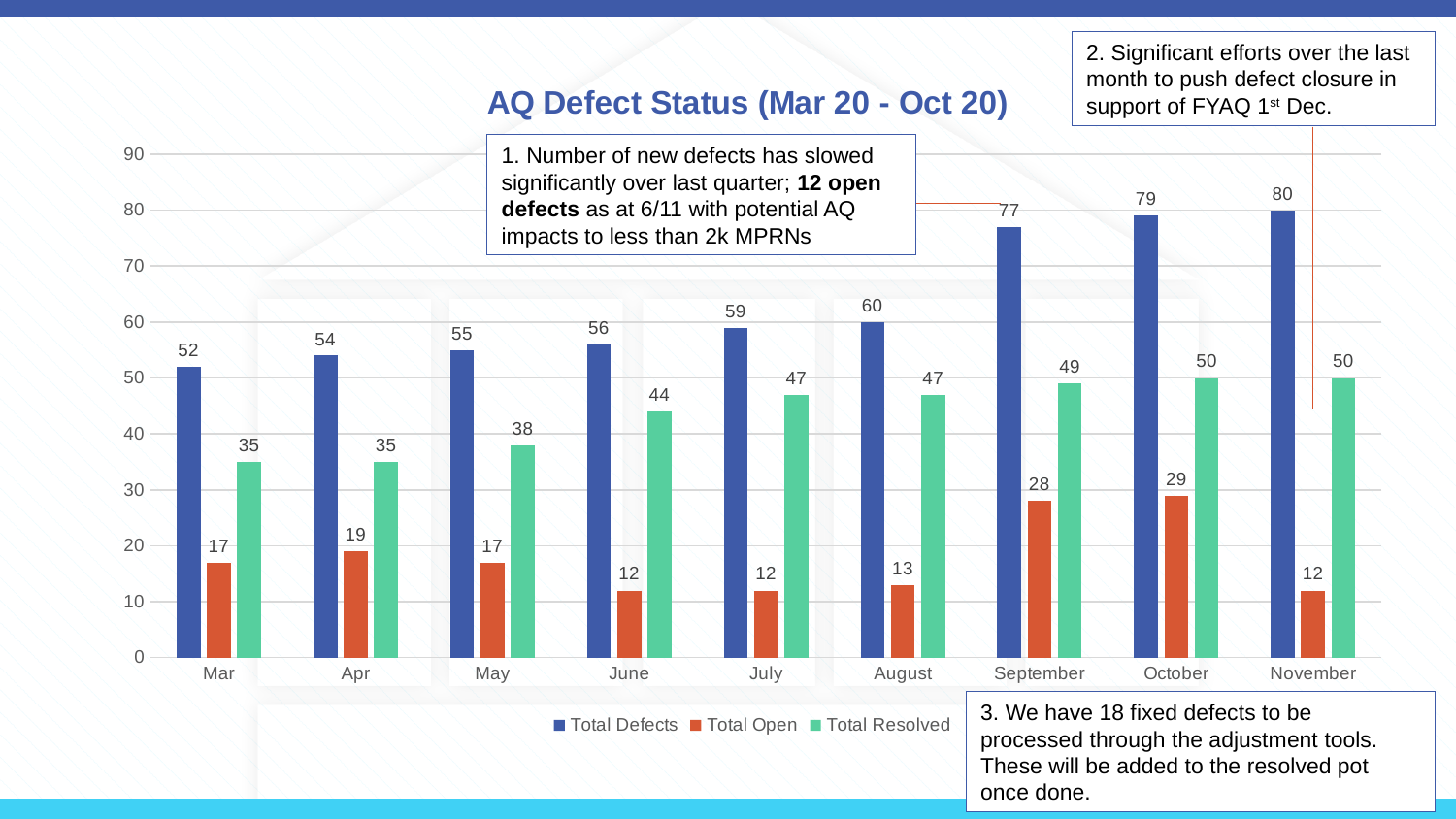
What is the Total Resolved value for June? 44 What is the Total Defects value for November? 80 How many series does the legend list? 3 Which month has the lowest Total Defects value? Mar Which month has the highest Total Defects value? November What is the difference between Total Defects and Total Resolved in October? 29 Is the Total Open value larger in September or in November? September What is the title of the chart? AQ Defect Status (Mar 20 - Oct 20) What kind of chart is shown on the slide? Bar chart How many months are shown on the x axis? 9 Do the Total Defects values rise or fall from Mar to November? Rise What is the Total Open value for September? 28